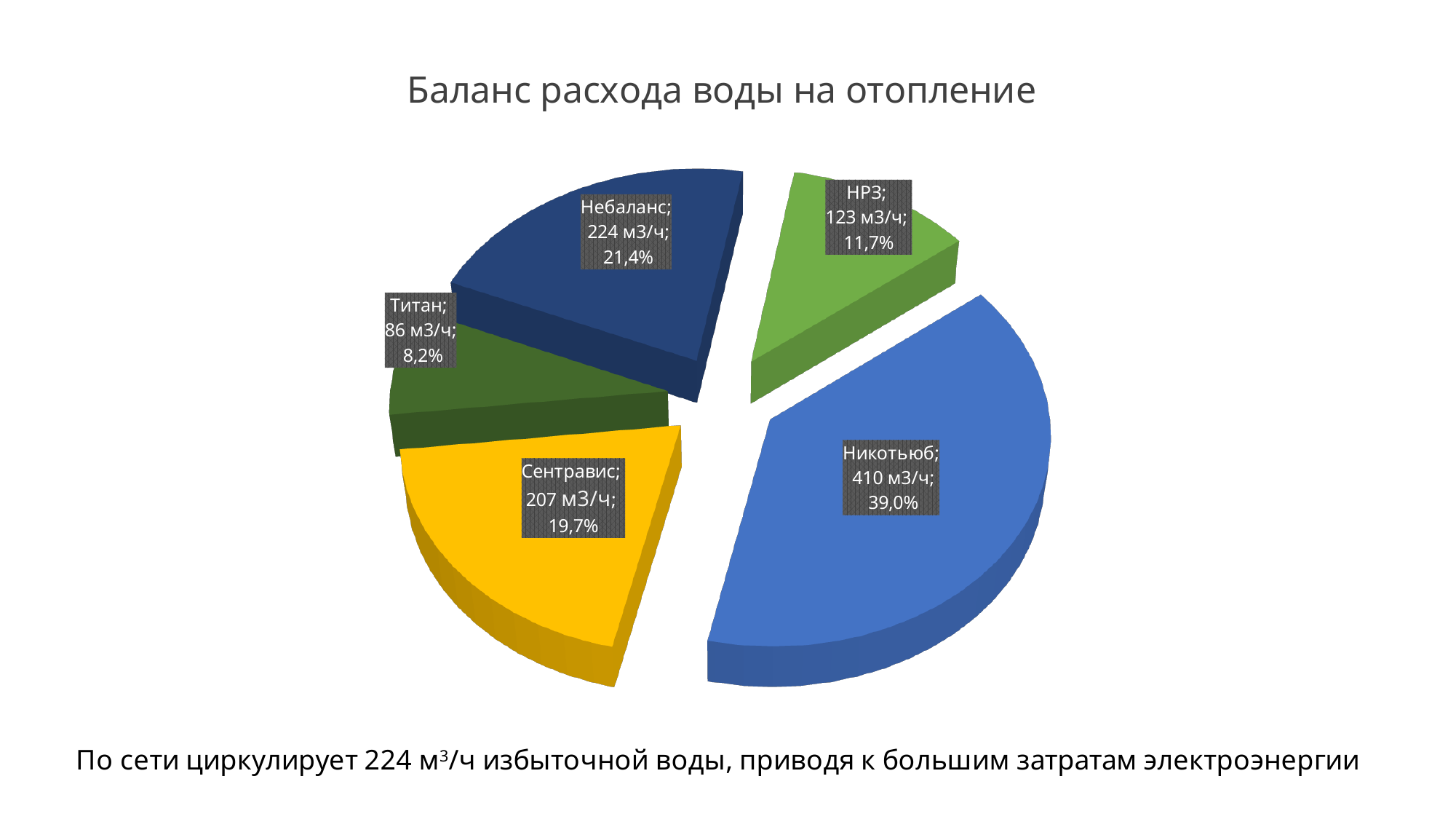
What kind of chart is shown on the slide? pie chart What is the title of the chart? Баланс расхода воды на отопление Which category has the largest slice? Никотьюб What is the value for Титан? 86 м3/ч What is the value for Сентравис? 207 м3/ч What is the difference between the values for Никотьюб and Сентравис? 203 м3/ч Which is larger, the value for Небаланс or the value for НРЗ? Небаланс What share of the pie does НРЗ represent? 11,7% What share of the pie does Небаланс represent? 21,4% How many slices does the pie chart have? 5 What is the value for Никотьюб? 410 м3/ч Which category has the smallest slice? Титан